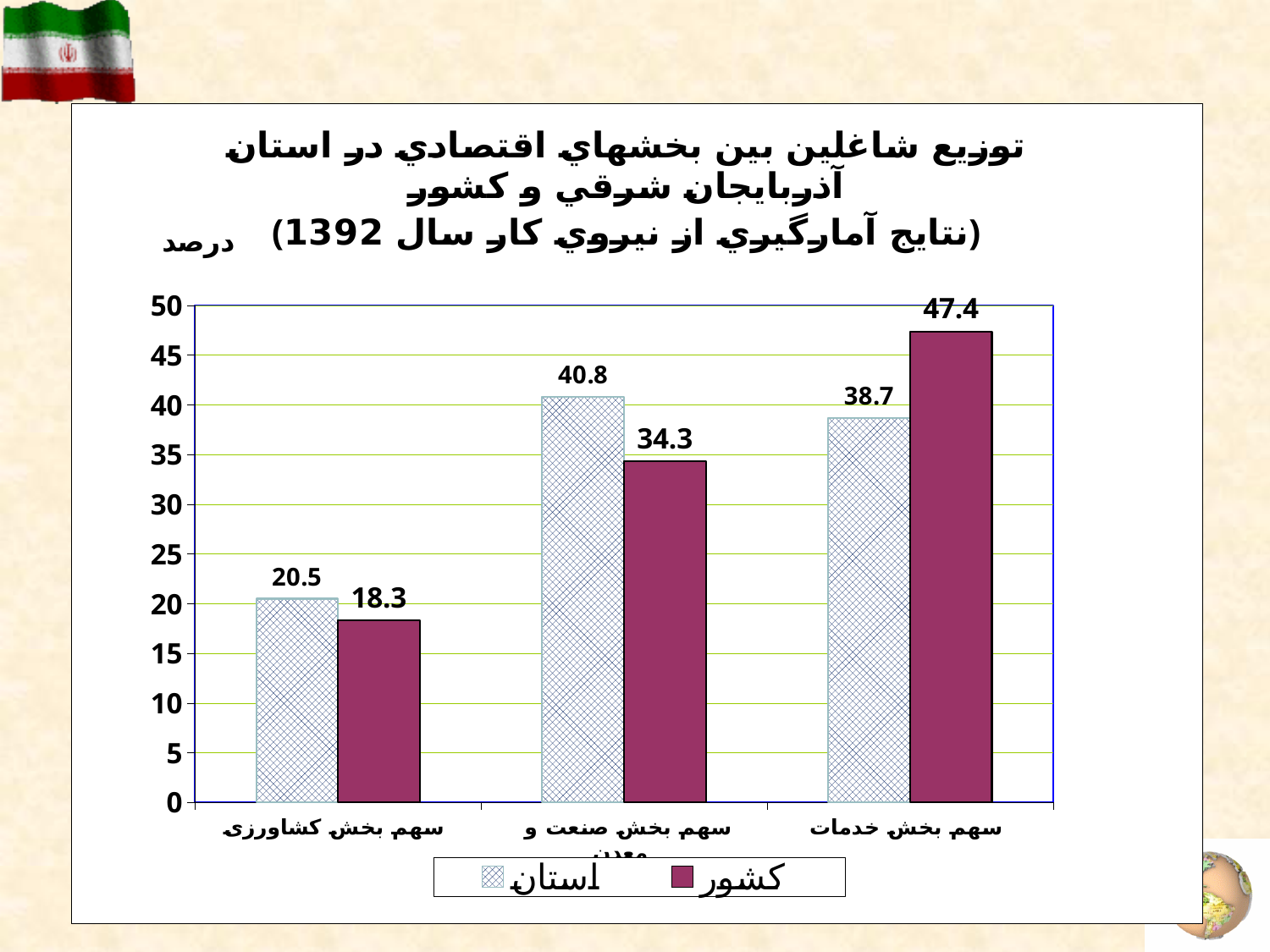
What kind of chart is shown on the slide? bar chart What is the difference between the کشور and استان values in the سهم بخش خدمات category? 8.7 What is the value for استان (province) in the سهم بخش کشاورزی category? 20.5 Which category has the lowest value for the کشور (country) series? سهم بخش کشاورزی What is the difference between the استان and کشور values in the سهم بخش کشاورزی category? 2.2 How many categories are shown on the x axis? 3 How many series does the legend list? 2 What is the value for استان (province) in the سهم بخش خدمات category? 38.7 What is the value for کشور (country) in the سهم بخش صنعت و معدن category? 34.3 What is the value for کشور (country) in the سهم بخش خدمات category? 47.4 Which category has the highest value for the استان (province) series? سهم بخش صنعت و معدن In the سهم بخش صنعت و معدن category, which series has the larger value, استان or کشور? استان